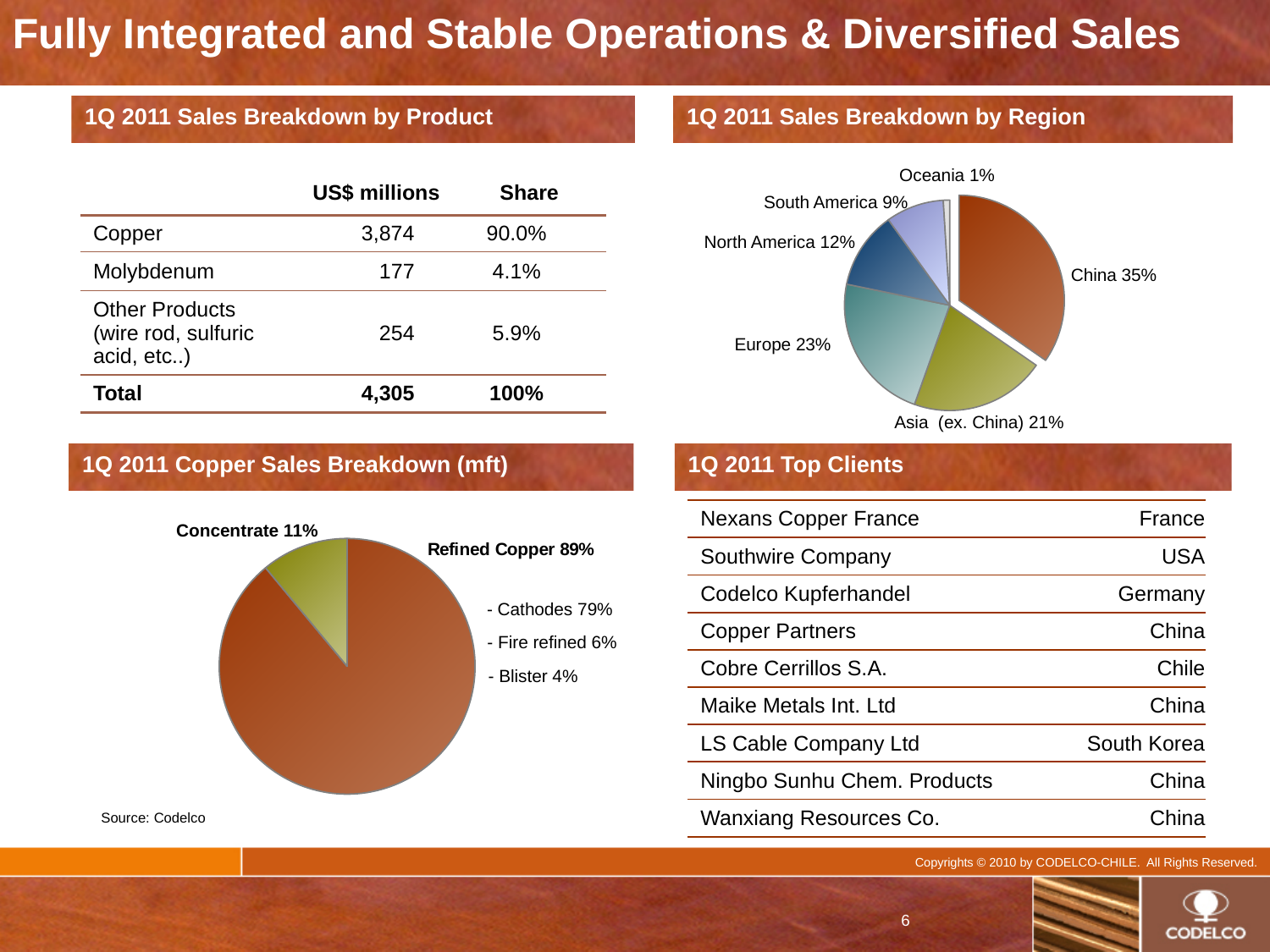
In the 1Q 2011 Sales Breakdown by Region chart, what share of sales does China account for? 35% In the 1Q 2011 Copper Sales Breakdown (mft) chart, what share of copper sales is listed as Cathodes? 79% In the 1Q 2011 Sales Breakdown by Region chart, how many percentage points larger is Europe's share than South America's share? 14 In the 1Q 2011 Sales Breakdown by Region chart, what share of sales does North America account for? 12% In the 1Q 2011 Sales Breakdown by Region chart, which region has the smallest share of sales? Oceania What type of chart is used for the 1Q 2011 Sales Breakdown by Region? Pie chart In the 1Q 2011 Sales Breakdown by Region chart, which has the larger share, Europe or Asia (ex. China)? Europe How many regions are shown in the 1Q 2011 Sales Breakdown by Region pie chart? 6 In the 1Q 2011 Copper Sales Breakdown (mft) chart, what share is Refined Copper? 89% In the 1Q 2011 Copper Sales Breakdown (mft) chart, what share is Concentrate? 11% In the 1Q 2011 Sales Breakdown by Region chart, what share of sales does Europe account for? 23% In the 1Q 2011 Sales Breakdown by Region chart, which region has the largest share of sales? China